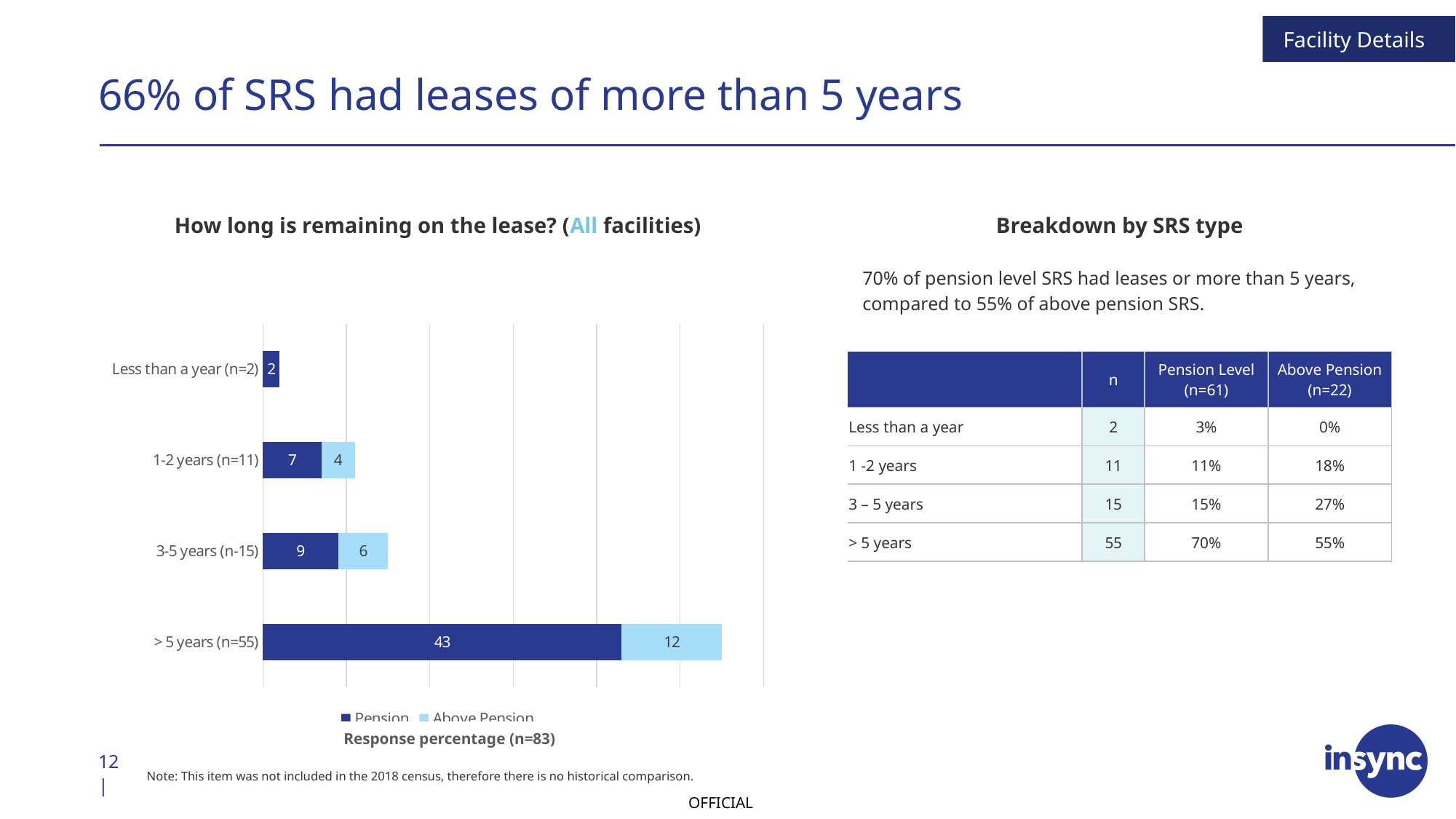
How many series does the chart's legend list? 2 How many categories are shown on the chart? 4 What is the Pension value for the '1-2 years (n=11)' category? 7 What is the total of the stacked bar for '1-2 years (n=11)'? 11 Which is larger for the '3-5 years (n-15)' category: the Pension value or the Above Pension value? Pension What is the Above Pension value for the '> 5 years (n=55)' category? 12 What is the Pension value for the '> 5 years (n=55)' category? 43 Which category has the lowest Pension value? Less than a year (n=2) What is the Above Pension value for the '3-5 years (n-15)' category? 6 What is the difference between the Pension and Above Pension values for '> 5 years (n=55)'? 31 What type of chart is shown on the slide? bar chart Which category has the highest Pension value? > 5 years (n=55)